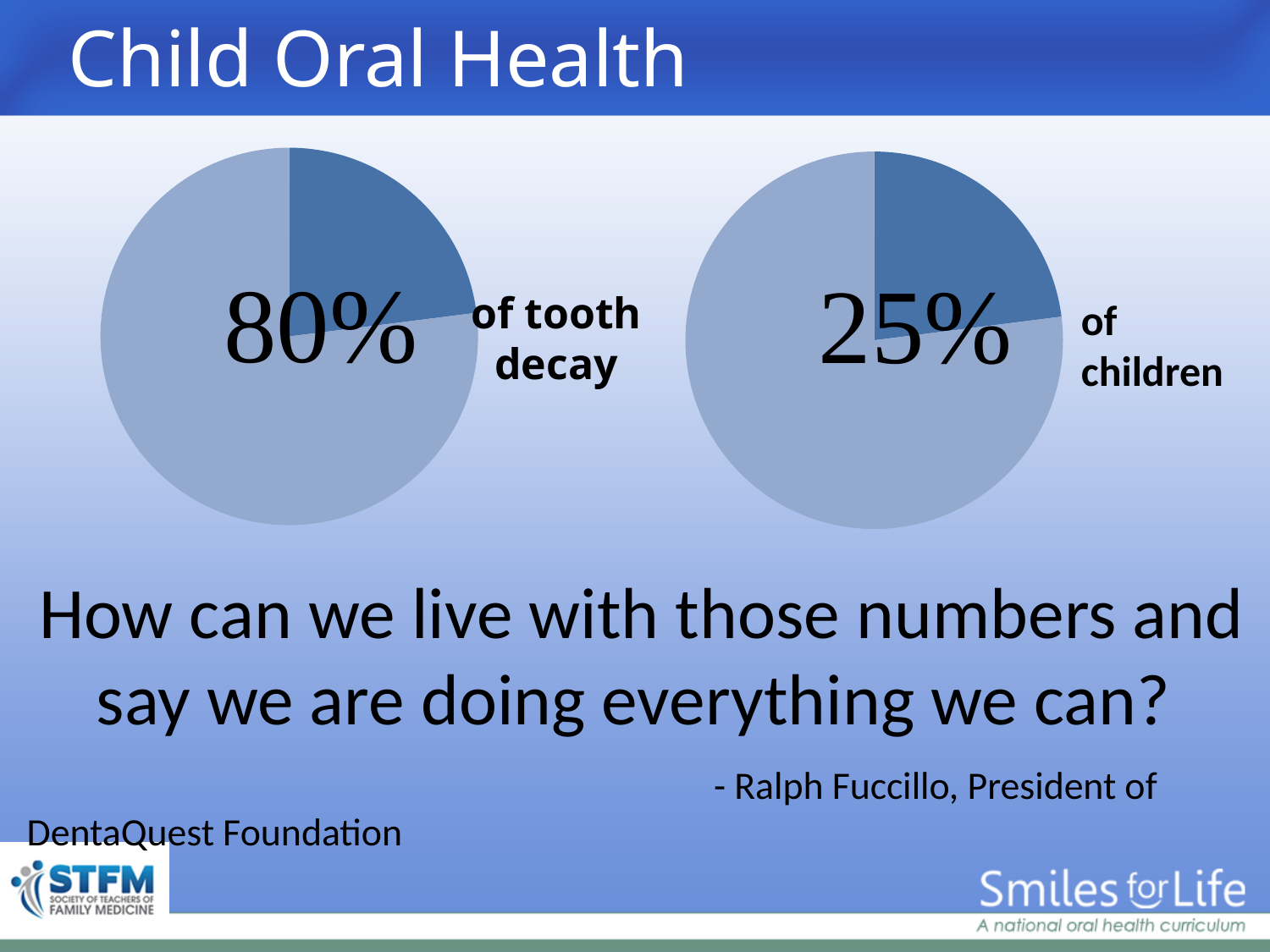
How many slices does the left pie chart have? 2 What is the difference between the percentage printed on the left pie chart and the percentage printed on the right pie chart? 55% How many slices does the right pie chart have? 2 What percentage is printed on the left pie chart? 80% What percentage is printed on the right pie chart? 25% Is the percentage printed on the right pie chart greater or less than 50%? less What kind of chart is shown on the right side of the slide? pie chart What kind of chart is shown on the left side of the slide? pie chart How many pie charts are on the slide? 2 Which printed percentage is larger, the one on the left pie chart or the one on the right pie chart? the left pie chart (80%) What does the 25% on the right pie chart refer to, according to the label next to it? of children What does the 80% on the left pie chart refer to, according to the label next to it? of tooth decay